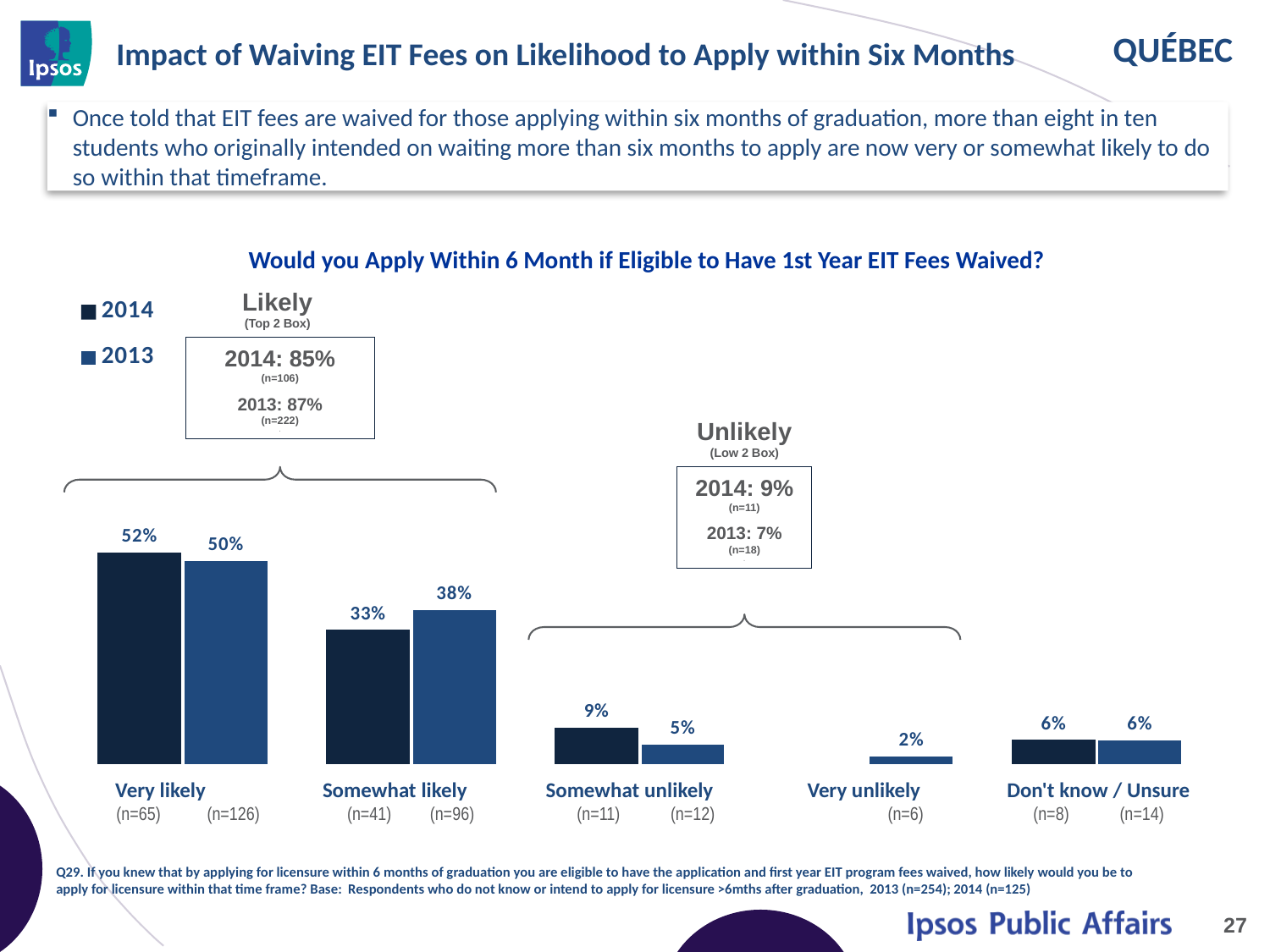
What is the 2013 value for Very unlikely? 2% Which category has the highest value for 2014? Very likely What is the Unlikely (Low 2 Box) percentage for 2013? 7% What is the 2013 value for Somewhat likely? 38% What kind of chart is shown on the slide? Bar chart What is the Likely (Top 2 Box) percentage for 2014? 85% What is the difference between the 2014 and 2013 values for Somewhat likely? 5 percentage points What percentage of 2014 respondents said they were very likely to apply within 6 months? 52% How many series does the legend list? 2 Which is larger for Somewhat unlikely, the 2014 value or the 2013 value? 2014 Which category has the lowest value for 2013? Very unlikely How many response categories are shown on the x axis? 5